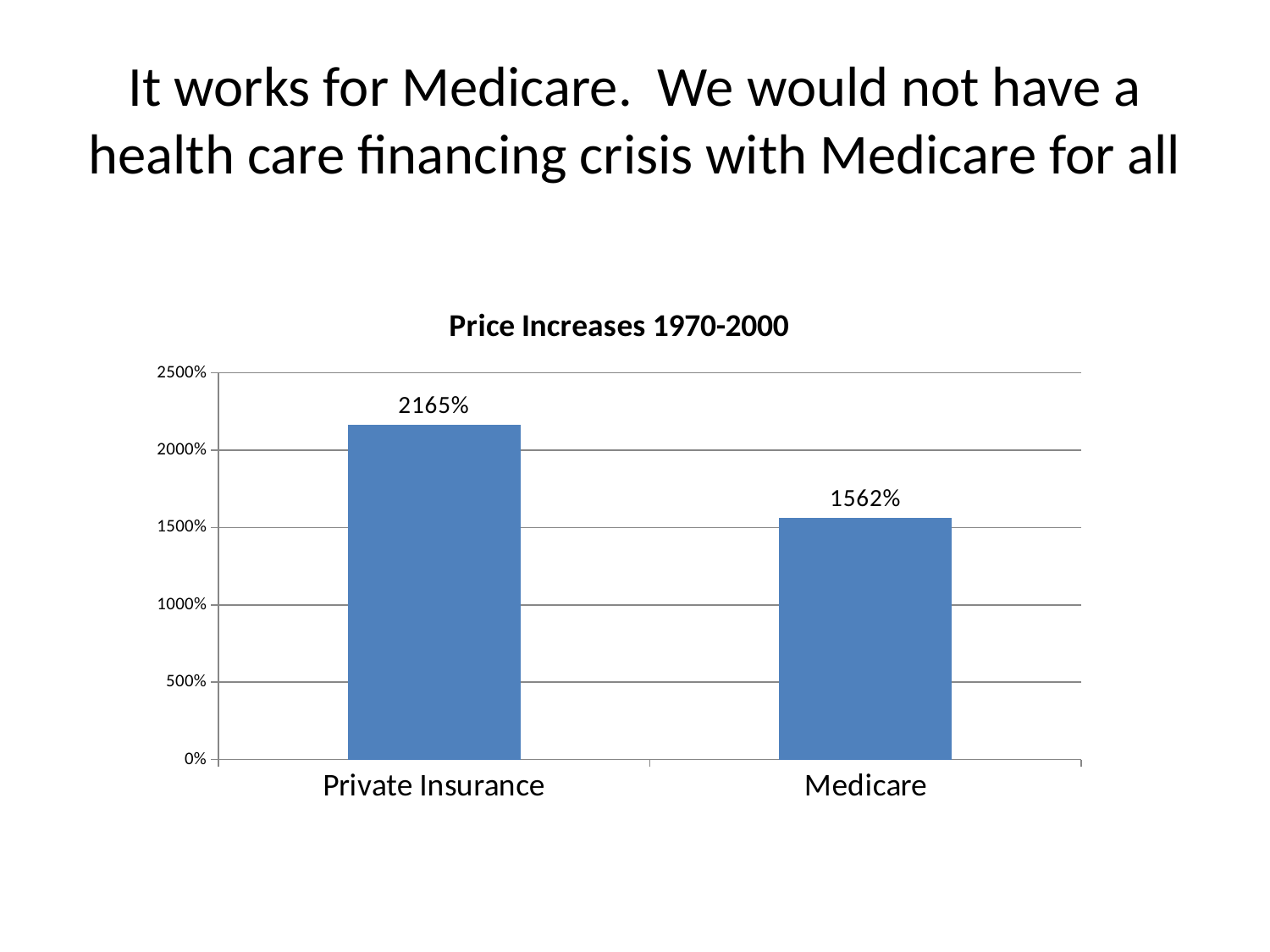
What is the difference between the values for Private Insurance and Medicare? 603% What is the value for Private Insurance? 2165% What is the highest value shown on the vertical axis? 2500% Which category has the highest value? Private Insurance How many categories are shown in the chart? 2 What kind of chart is shown on the slide? bar chart Is the value for Medicare greater or less than 2000%? less Is the value for Private Insurance greater or less than 2000%? greater Which is larger, the value for Private Insurance or the value for Medicare? Private Insurance What is the title of the chart? Price Increases 1970-2000 Which category has the lowest value? Medicare What is the value for Medicare? 1562%